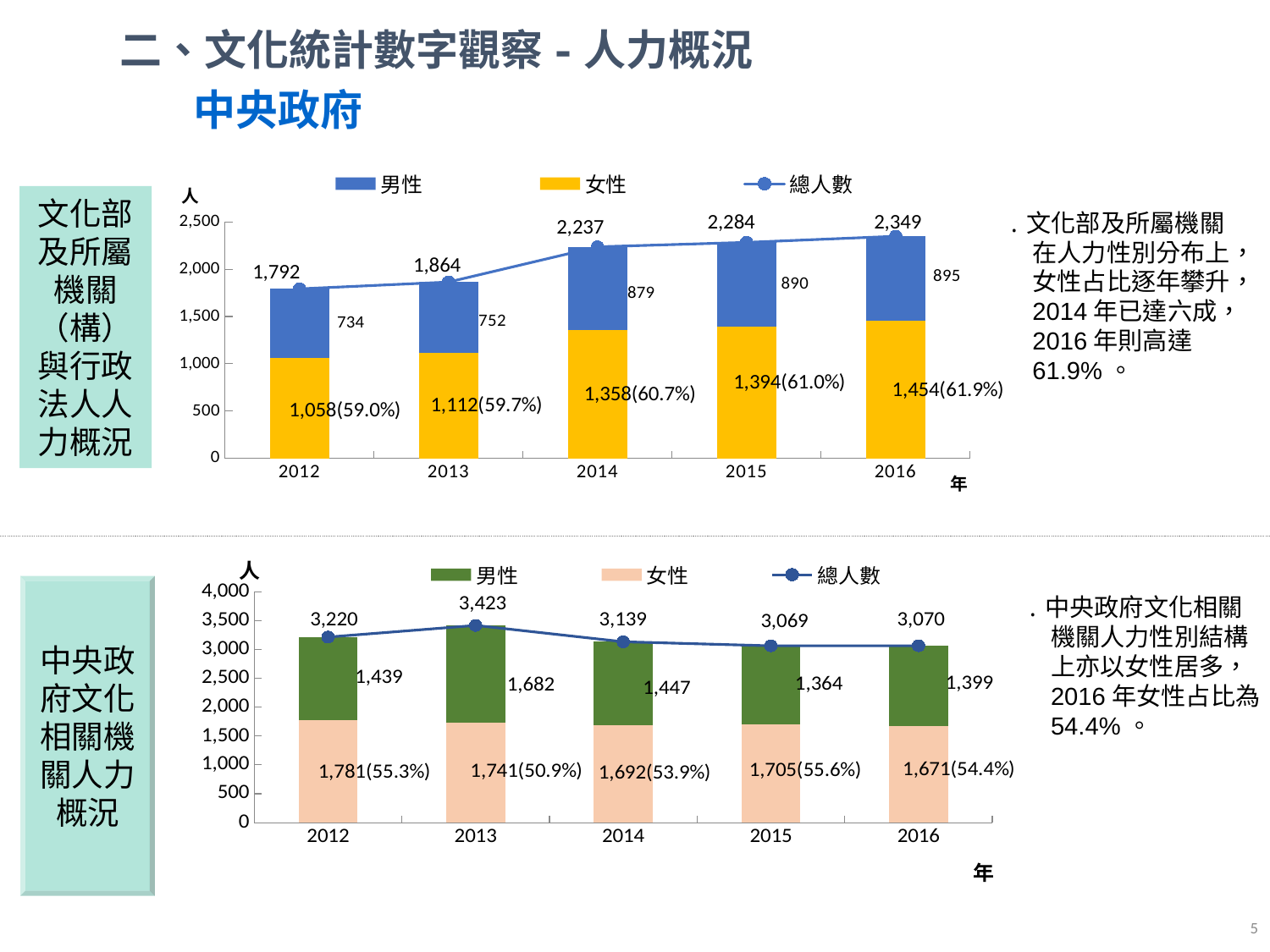
In the bottom chart, what is the 女性 value for 2014? 1,692(53.9%) In the top chart, what is the 女性 value for 2016? 1,454(61.9%) In the top chart, what is the difference between the 男性 values for 2015 and 2013? 138 In the bottom chart, which is larger, the 男性 value for 2013 or the 男性 value for 2016? 2013 In the bottom chart, which year has the lowest 總人數? 2015 In the top chart, which year has the highest 總人數? 2016 In the bottom chart (中央政府文化相關機關人力概況), what is the 總人數 value for 2013? 3,423 In the top chart (文化部及所屬機關(構)與行政法人人力概況), what is the 總人數 value for 2014? 2,237 How many series does the legend of the bottom chart list? 3 In the top chart, does the 總人數 line rise or fall from 2012 to 2016? rise In the top chart, what is the 男性 value for 2012? 734 How many years are shown on the x axis of the top chart? 5